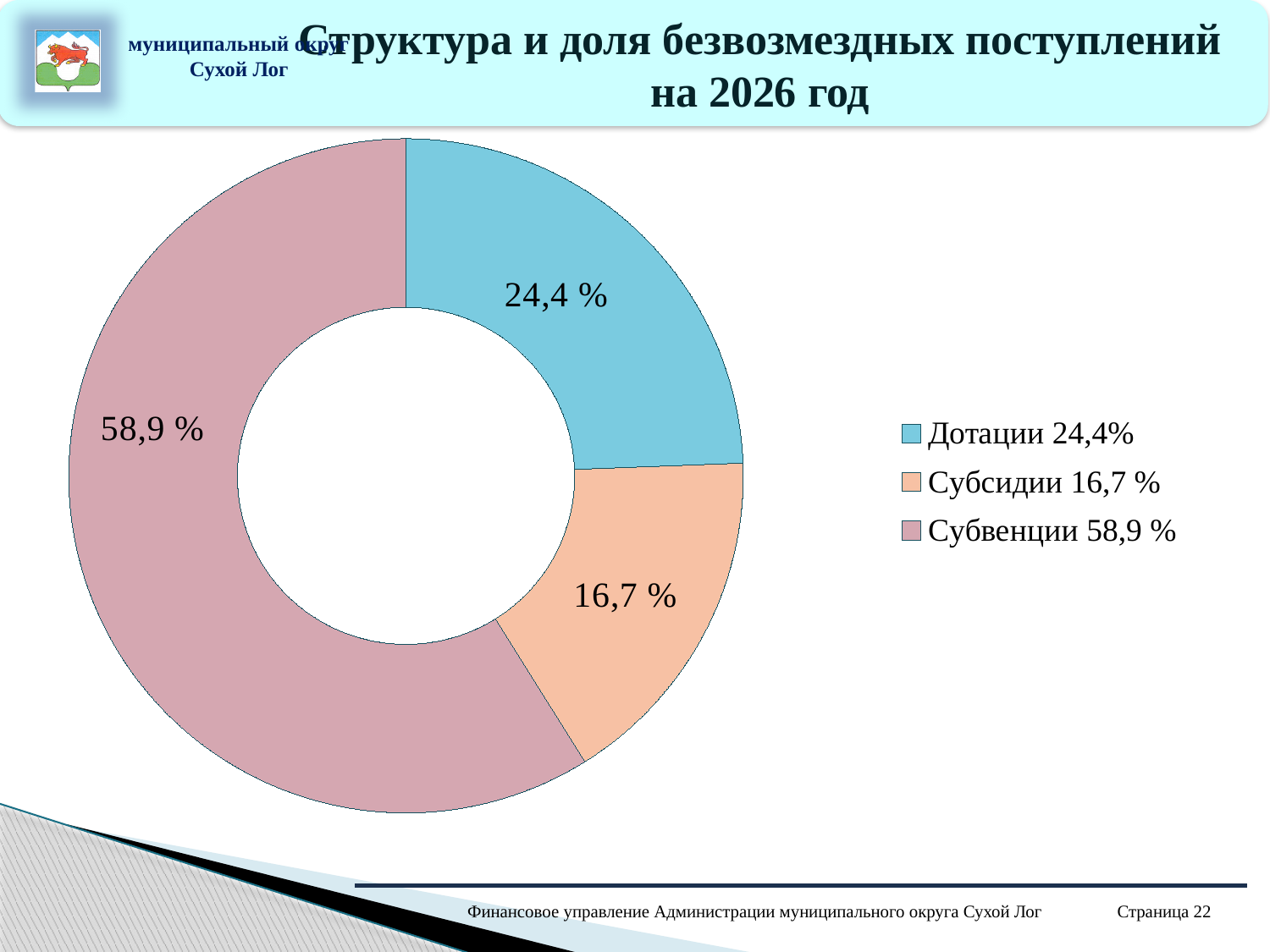
How many categories are shown in the chart? 3 What is the value shown for Дотации? 24,4 % What is the value shown for Субсидии? 16,7 % What share of the chart does Субвенции account for? 58,9 % Which is larger, Дотации or Субсидии? Дотации What is the difference in percentage points between Субвенции and Дотации? 34,5 What kind of chart is shown on the slide? Pie chart (doughnut) What is the difference in percentage points between Дотации and Субсидии? 7,7 What is the title of the chart on the slide? Структура и доля безвозмездных поступлений на 2026 год Which colour represents Субсидии in the chart? Orange (peach) Which category has the smallest share? Субсидии Which category has the largest share? Субвенции